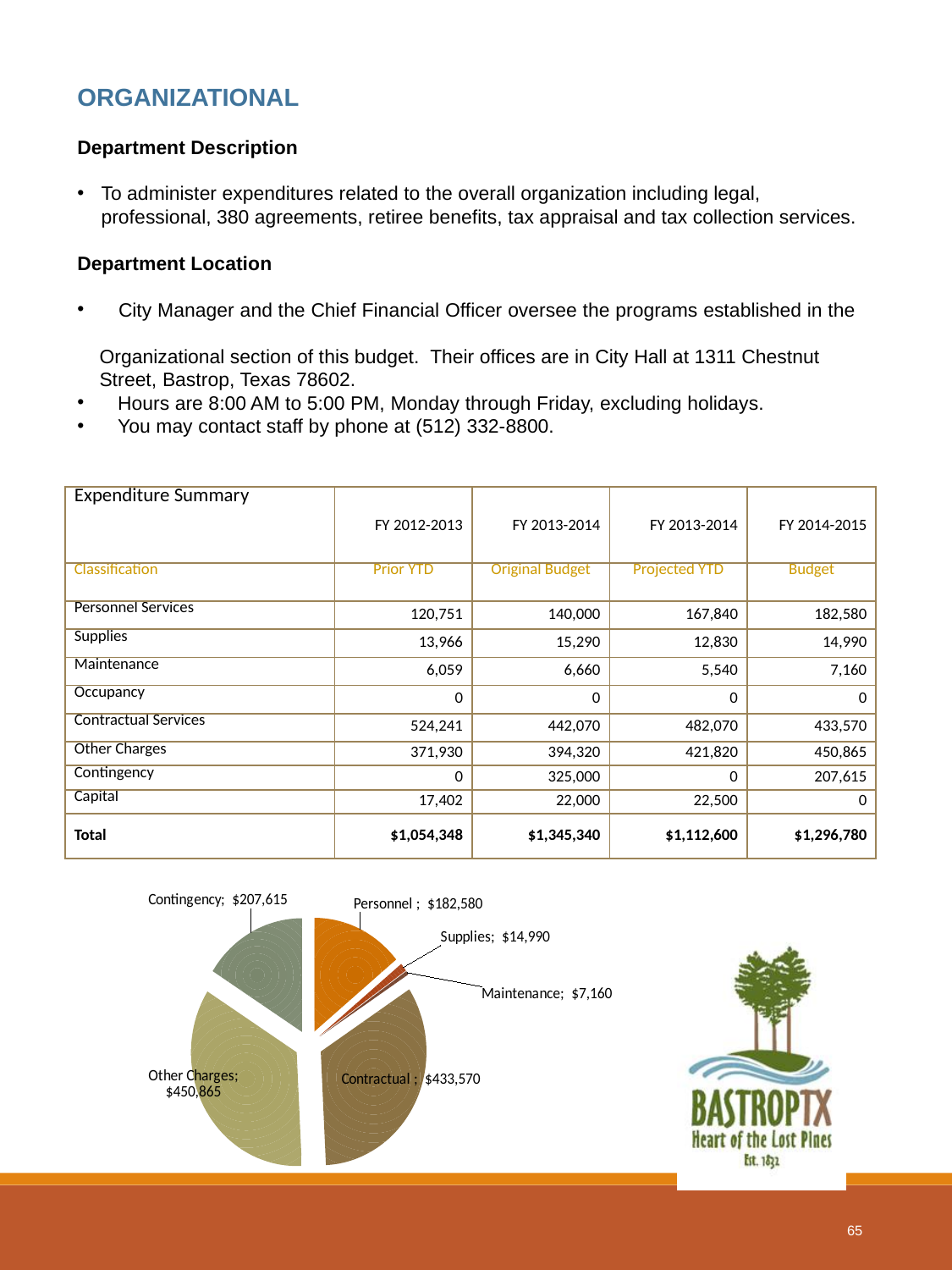
In the pie chart, which is larger: Contingency or Personnel? Contingency What colour is the Personnel slice in the pie chart? Orange How many slices does the pie chart have? 6 What kind of chart is shown at the bottom of the slide? Pie chart Which slice of the pie chart has the largest value? Other Charges In the pie chart, what is the difference between Personnel and Supplies? $167,590 In the pie chart, what is the value for Contingency? $207,615 In the pie chart, what is the value for Contractual? $433,570 In the pie chart, what is the value for Maintenance? $7,160 Which slice of the pie chart has the smallest value? Maintenance In the pie chart, what is the difference between Other Charges and Contractual? $17,295 What share of the pie chart does Contractual represent, given the total of $1,296,780? 33.4%